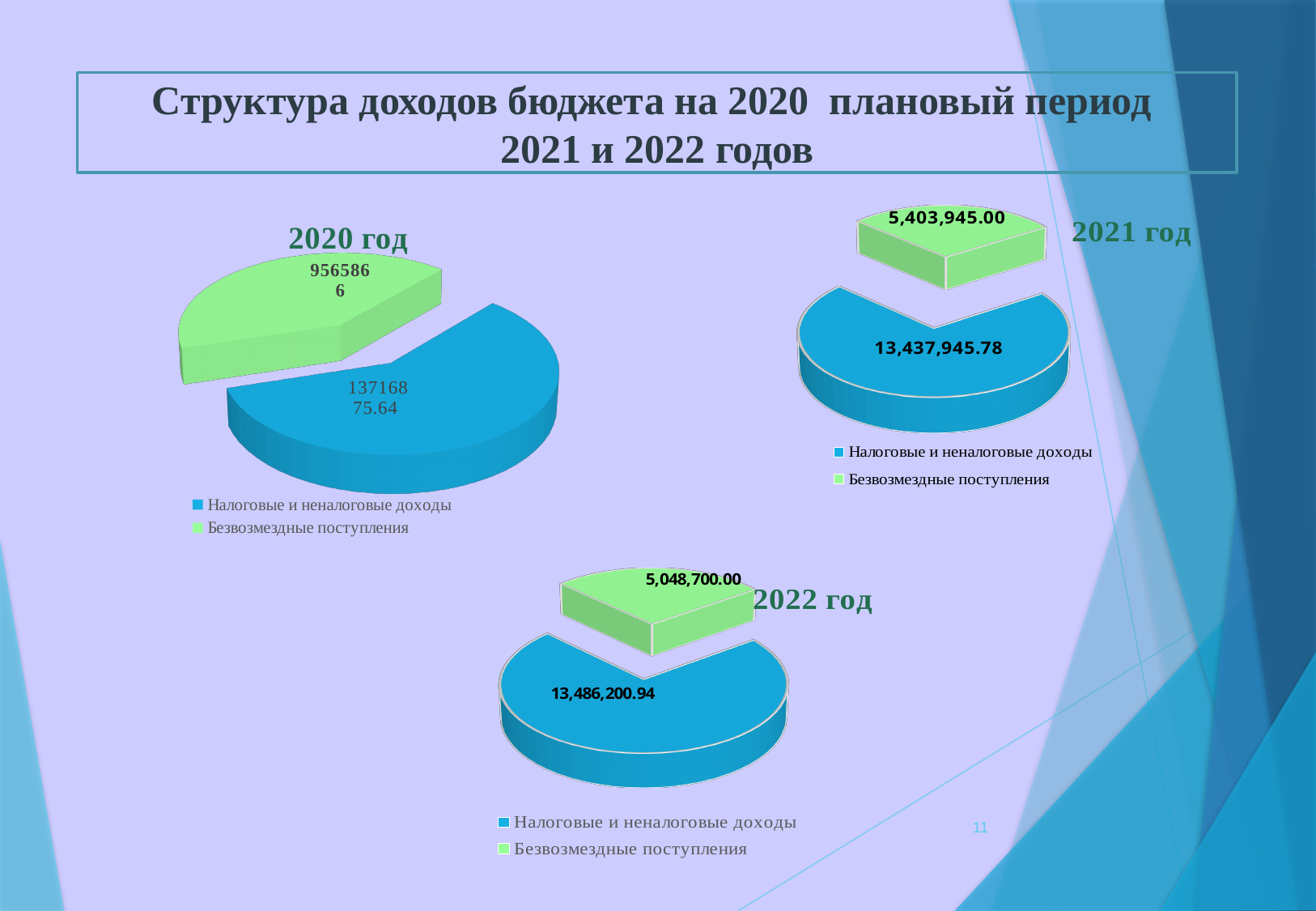
In the 2021 год chart, what is the value for Безвозмездные поступления? 5,403,945.00 What kind of chart is used for the 2020 год chart? Pie chart In the 2021 год chart, what is the difference between Налоговые и неналоговые доходы and Безвозмездные поступления? 8,034,000.78 In the 2022 год chart, what is the value for Безвозмездные поступления? 5,048,700.00 How many entries does the legend of the 2021 год chart list? 2 In the 2021 год chart, what is the value for Налоговые и неналоговые доходы? 13,437,945.78 In the 2022 год chart, which category has the largest slice? Налоговые и неналоговые доходы In the 2022 год chart, what is the difference between Налоговые и неналоговые доходы and Безвозмездные поступления? 8,437,500.94 In the 2021 год chart, which is larger: Налоговые и неналоговые доходы or Безвозмездные поступления? Налоговые и неналоговые доходы In the 2022 год chart, what is the value for Налоговые и неналоговые доходы? 13,486,200.94 In the 2020 год chart, which category has the smallest slice? Безвозмездные поступления How many slices does the 2022 год pie chart have? 2